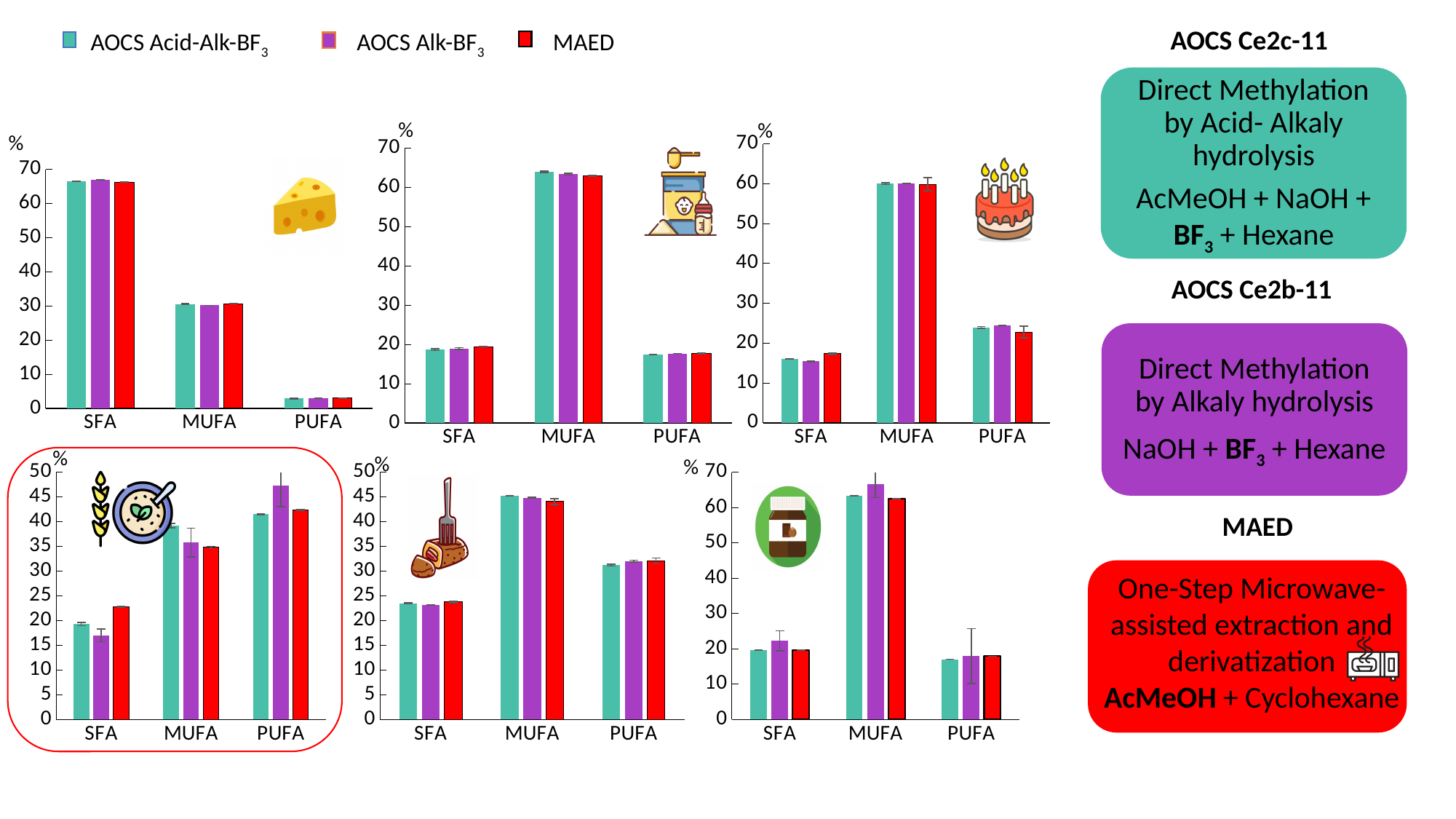
Which colour represents the MAED series in the legend? red In the top-left chart, is the AOCS Acid-Alk-BF3 value for SFA greater or less than 60? greater In the bottom-middle chart, which is larger, the MAED value for MUFA or the MAED value for PUFA? MUFA In the bottom-right chart, is the AOCS Alk-BF3 value for MUFA greater or less than 60? greater In the bottom-middle chart, which category has the lowest values? SFA What kind of chart is the top-left chart? bar chart In the top-left chart, which category has the lowest values? PUFA In the top-left chart, which category has the highest values? SFA In the bottom-left chart, which category has the highest values? PUFA How many series does the legend at the top of the slide list? 3 How many categories are shown on the x axis of the top-middle chart? 3 In the top-right chart, which category has the highest values? MUFA